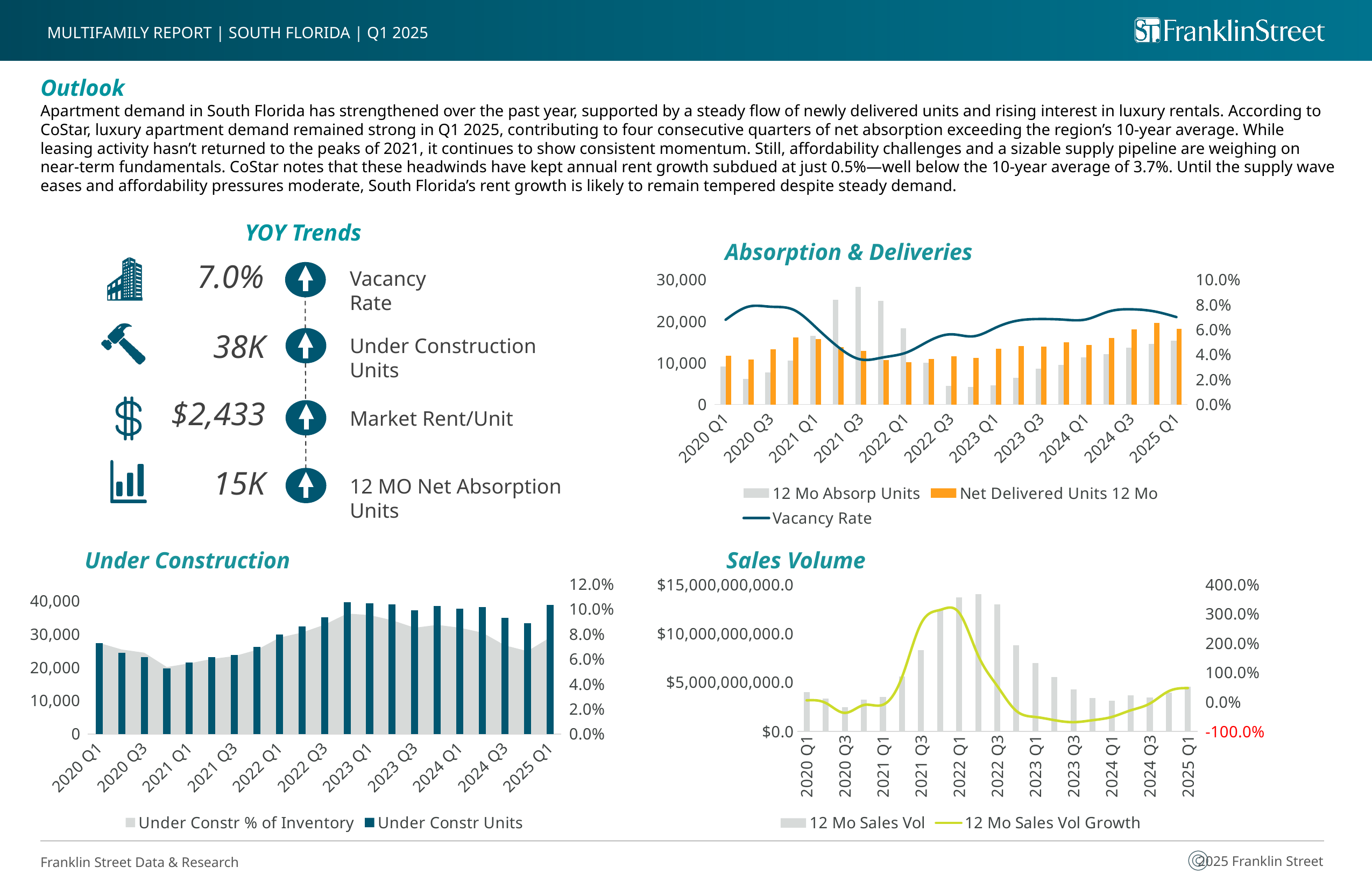
In the Absorption & Deliveries chart, which is larger for 2022 Q3: 12 Mo Absorp Units or Net Delivered Units 12 Mo? Net Delivered Units 12 Mo In the Absorption & Deliveries chart, which quarter has the highest 12 Mo Absorp Units bar? 2021 Q3 In the Under Construction chart, is the Under Constr Units value for 2021 Q1 greater or less than 30,000? less In the Absorption & Deliveries chart, is the 12 Mo Absorp Units value for 2021 Q3 greater or less than 20,000? greater In the Sales Volume chart, is the 12 Mo Sales Vol for 2022 Q2 greater or less than $10,000,000,000.0? greater In the Absorption & Deliveries chart, how many series does the legend list? 3 In the Under Construction chart, which quarter has the lowest Under Constr Units bar? 2020 Q4 In the Under Construction chart, do Under Constr Units rise or fall from 2021 Q1 to 2023 Q1? rise In the Sales Volume chart, which quarter has the larger 12 Mo Sales Vol: 2022 Q2 or 2023 Q1? 2022 Q2 In the Under Construction chart, how many series does the legend list? 2